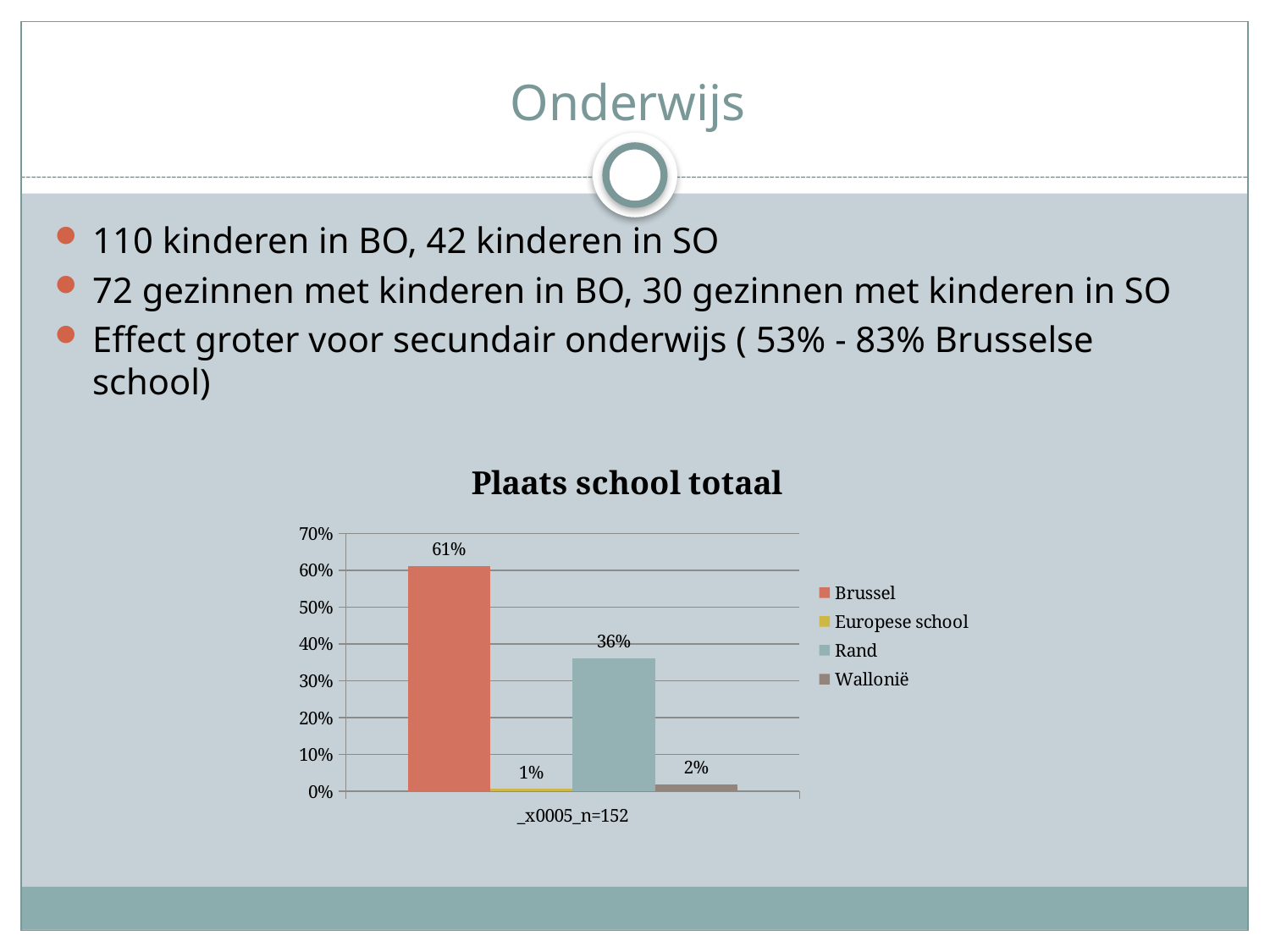
Which series has the highest value in the chart? Brussel How many series does the legend list? 4 What is the title of the chart? Plaats school totaal What is the value for Europese school in the chart? 1% What kind of chart is shown on the slide? Bar chart What is the value for Brussel in the chart? 61% What is the value for Wallonië in the chart? 2% What is the difference between the values for Brussel and Rand? 25% Which series has the lowest value in the chart? Europese school What is the label shown below the x axis of the chart? _x0005_n=152 What is the value for Rand in the chart? 36% Which is larger, the value for Rand or the value for Wallonië? Rand